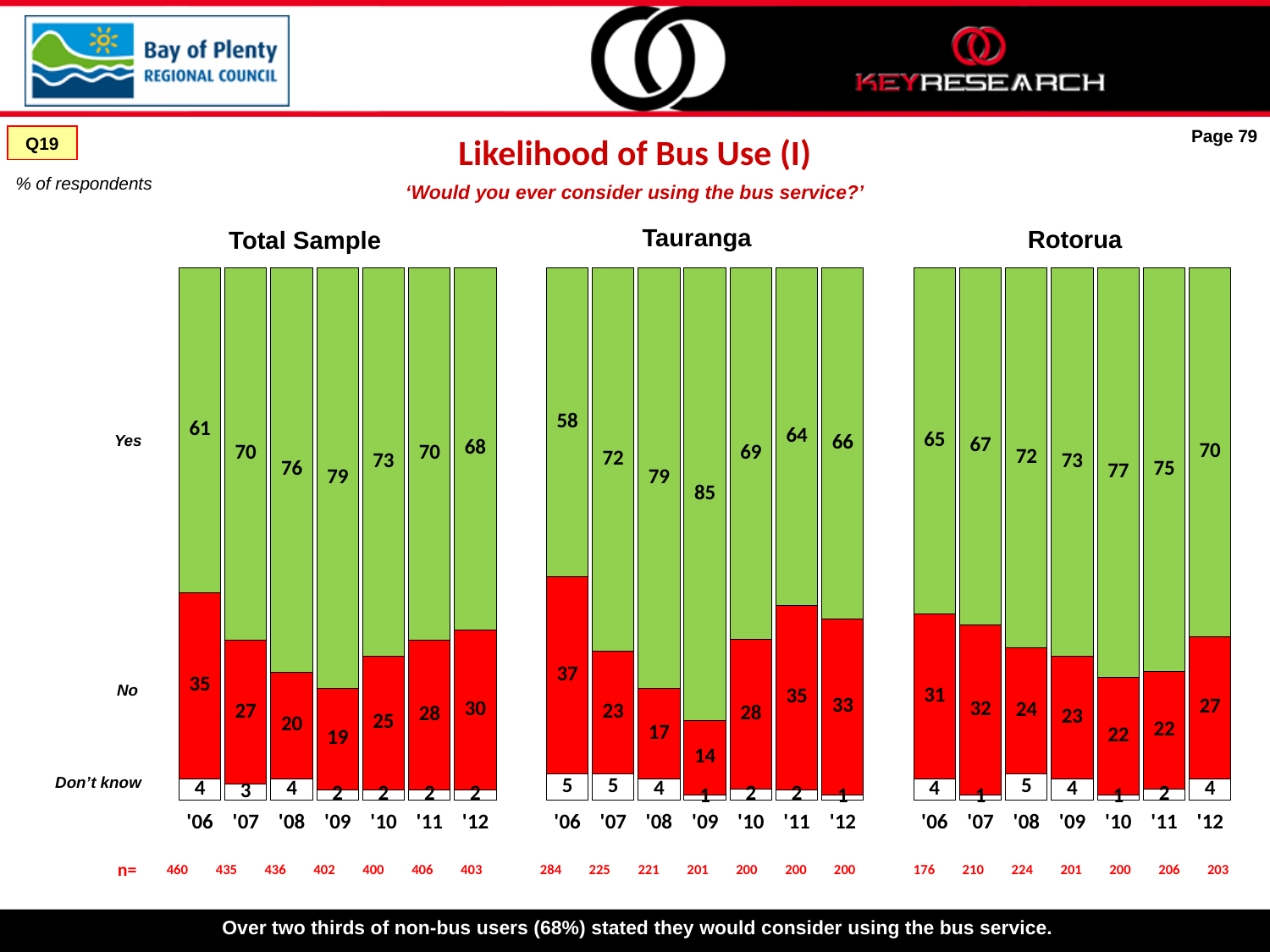
In the Total Sample chart, what is the difference between the Yes values for '09 and '06? 18 In the Tauranga chart, which year has the highest Yes value? '09 In the Rotorua chart, which year has the lowest Yes value? '06 How many charts are shown on the slide? 3 In the Total Sample chart, what is the total of the Yes, No and Don't know values for '12? 100 In the Rotorua chart, is the No value larger in '06 or in '10? '06 What type of chart is used for the Total Sample data? Stacked bar chart In the Total Sample chart, what percentage of respondents answered Yes in '09? 79 In the Tauranga chart, do the Yes values rise or fall from '06 to '09? Rise In the Tauranga chart, what is the No value for '06? 37 How many years are shown on the x axis of the Tauranga chart? 7 In the Rotorua chart, what is the Don't know value for '08? 5